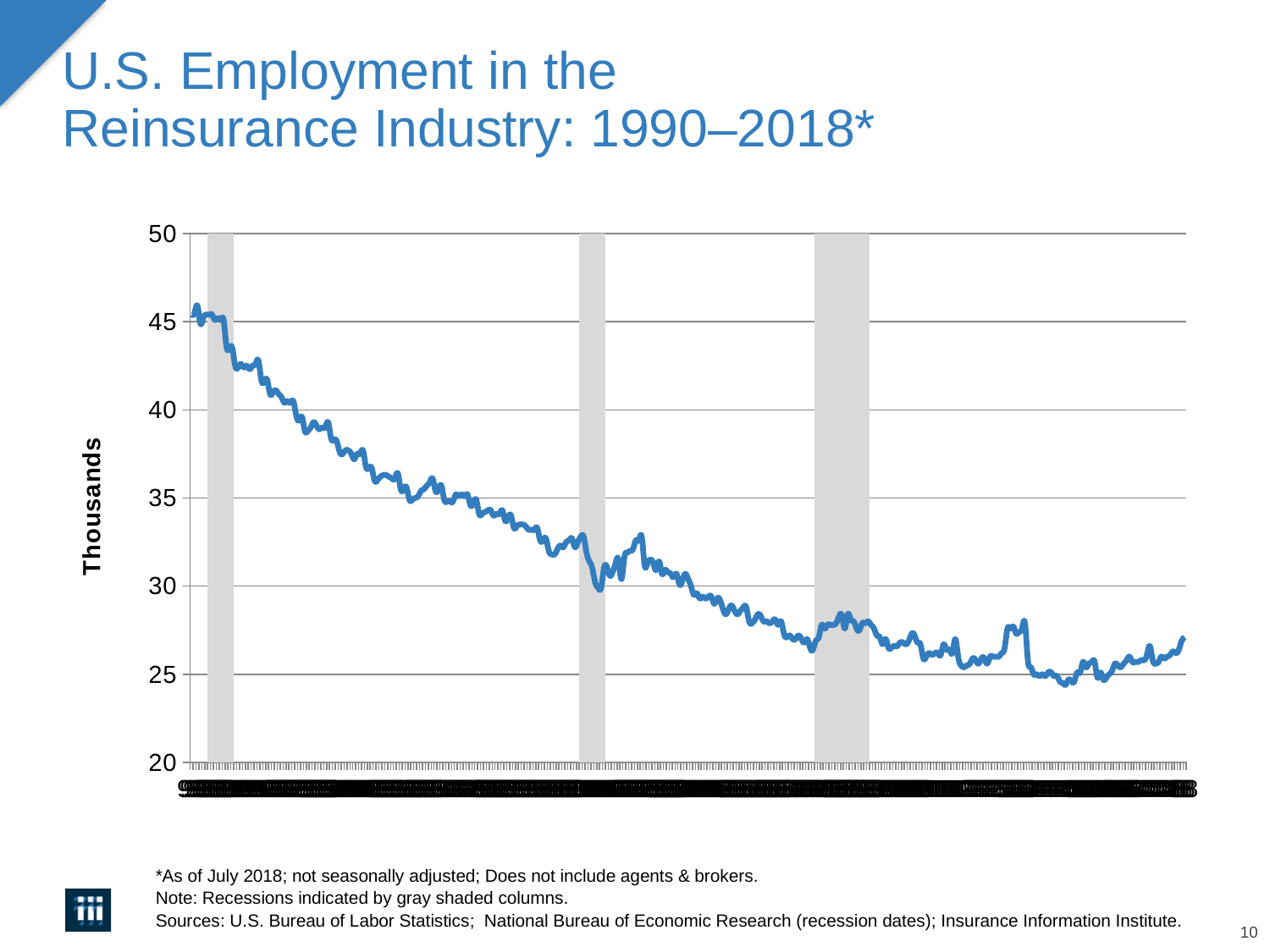
Is the value at the end of the series (2018) greater or less than 25? greater Is the value at the start of the series (1990) greater or less than 35? greater Is the value at the start of the series (1990) greater or less than 40? greater What kind of chart is shown on the slide? line chart What is the label on the vertical axis? Thousands How many gray shaded recession columns are shown on the chart? 3 What is the highest value shown on the vertical axis? 50 Do the values in the chart generally rise or fall from 1990 to 2018? fall Is the highest point of the line at the beginning or the end of the period? beginning